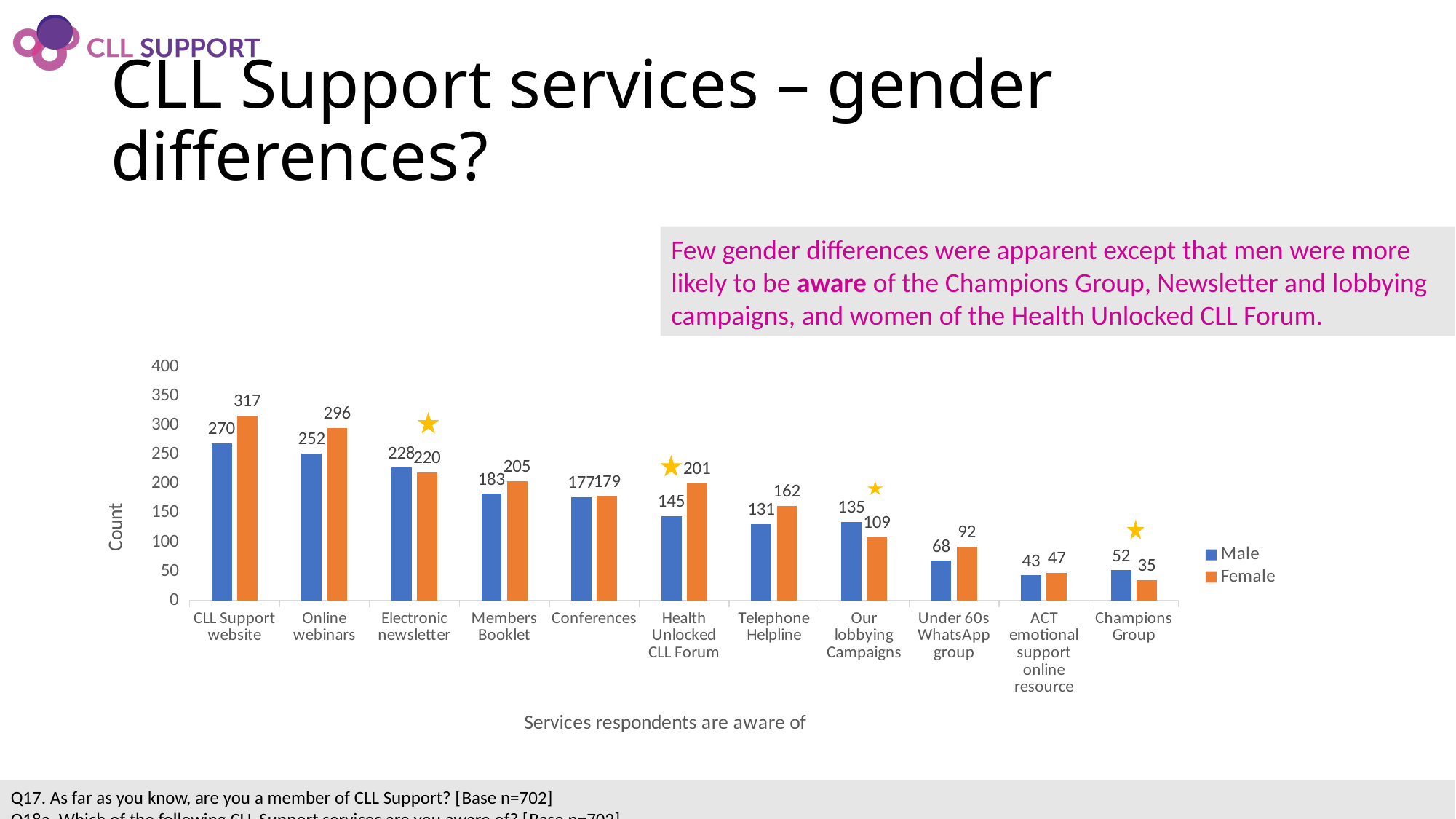
How many services are shown on the x axis? 11 Which service has the highest Female value? CLL Support website How many series does the legend list? 2 What is the difference between the Female and Male values for Telephone Helpline? 31 What kind of chart is shown on the slide? Bar chart What is the x-axis title of the chart? Services respondents are aware of What is the Female value for Health Unlocked CLL Forum? 201 For Our lobbying Campaigns, is the Male or Female value larger? Male What is the Male value for CLL Support website? 270 What is the Male value for Champions Group? 52 Which service has the lowest Male value? ACT emotional support online resource What is the Female value for Online webinars? 296